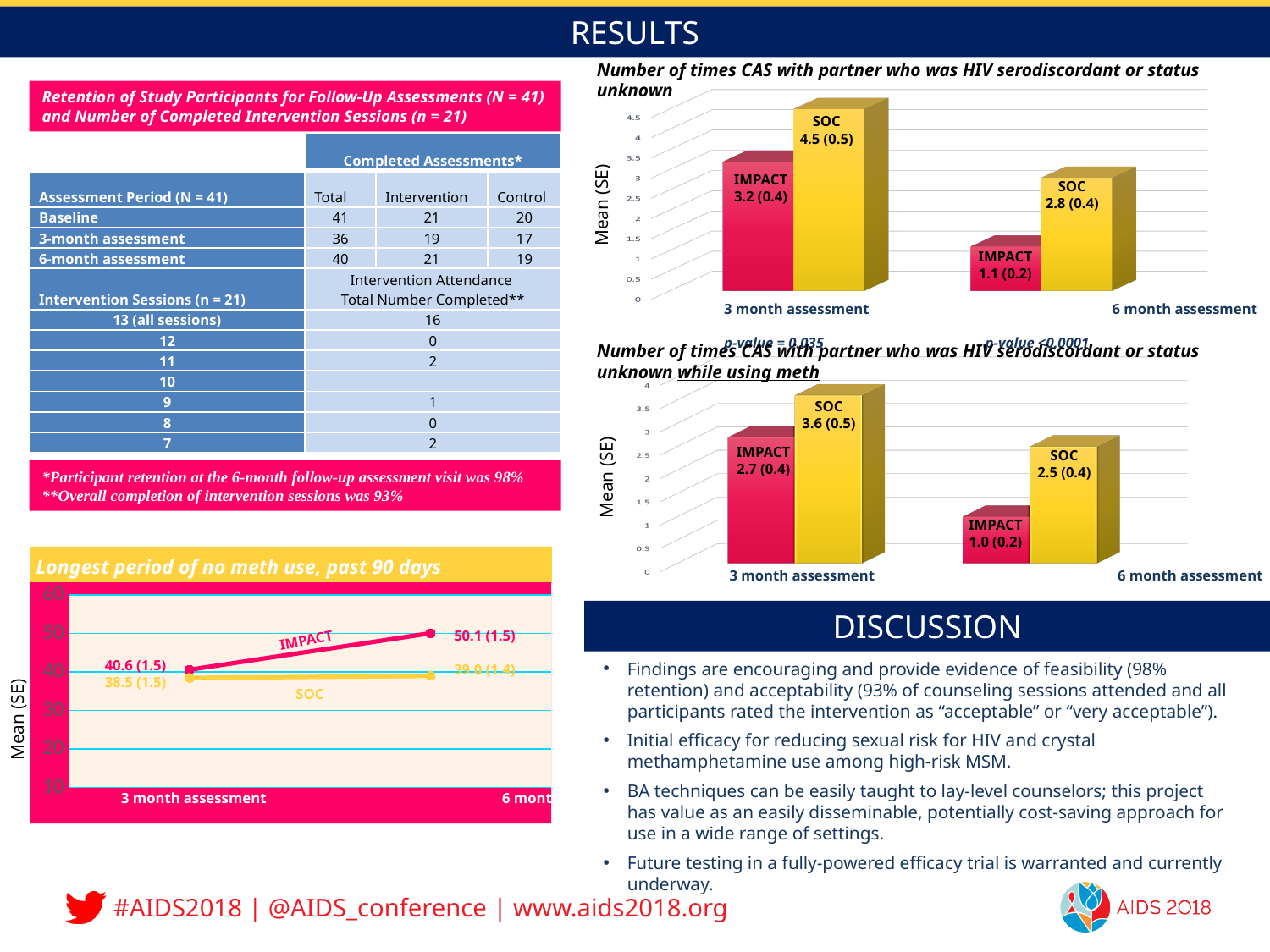
In the chart titled 'Number of times CAS with partner who was HIV serodiscordant or status unknown', does the IMPACT mean rise or fall from the 3 month to the 6 month assessment? fall In the chart titled 'Number of times CAS with partner who was HIV serodiscordant or status unknown while using meth', what is the SOC value at the 6 month assessment? 2.5 (0.4) In the chart titled 'Number of times CAS with partner who was HIV serodiscordant or status unknown while using meth', which bar is the lowest? IMPACT at 6 month assessment In the chart titled 'Number of times CAS with partner who was HIV serodiscordant or status unknown while using meth', what kind of chart is shown? bar chart In the chart titled 'Number of times CAS with partner who was HIV serodiscordant or status unknown', which bar is the highest? SOC at 3 month assessment In the chart titled 'Number of times CAS with partner who was HIV serodiscordant or status unknown', what is the difference between the SOC and IMPACT means at the 3 month assessment? 1.3 In the chart titled 'Number of times CAS with partner who was HIV serodiscordant or status unknown', what is the SOC value at the 3 month assessment? 4.5 (0.5) In the chart titled 'Number of times CAS with partner who was HIV serodiscordant or status unknown while using meth', what is the IMPACT value at the 3 month assessment? 2.7 (0.4) In the chart titled 'Longest period of no meth use, past 90 days', which group has the larger value at the 6 month assessment, IMPACT or SOC? IMPACT In the chart titled 'Longest period of no meth use, past 90 days', what is the IMPACT value at the 6 month assessment? 50.1 (1.5) In the chart titled 'Number of times CAS with partner who was HIV serodiscordant or status unknown', what is the IMPACT value at the 6 month assessment? 1.1 (0.2) In the chart titled 'Longest period of no meth use, past 90 days', what is the SOC value at the 3 month assessment? 38.5 (1.5)